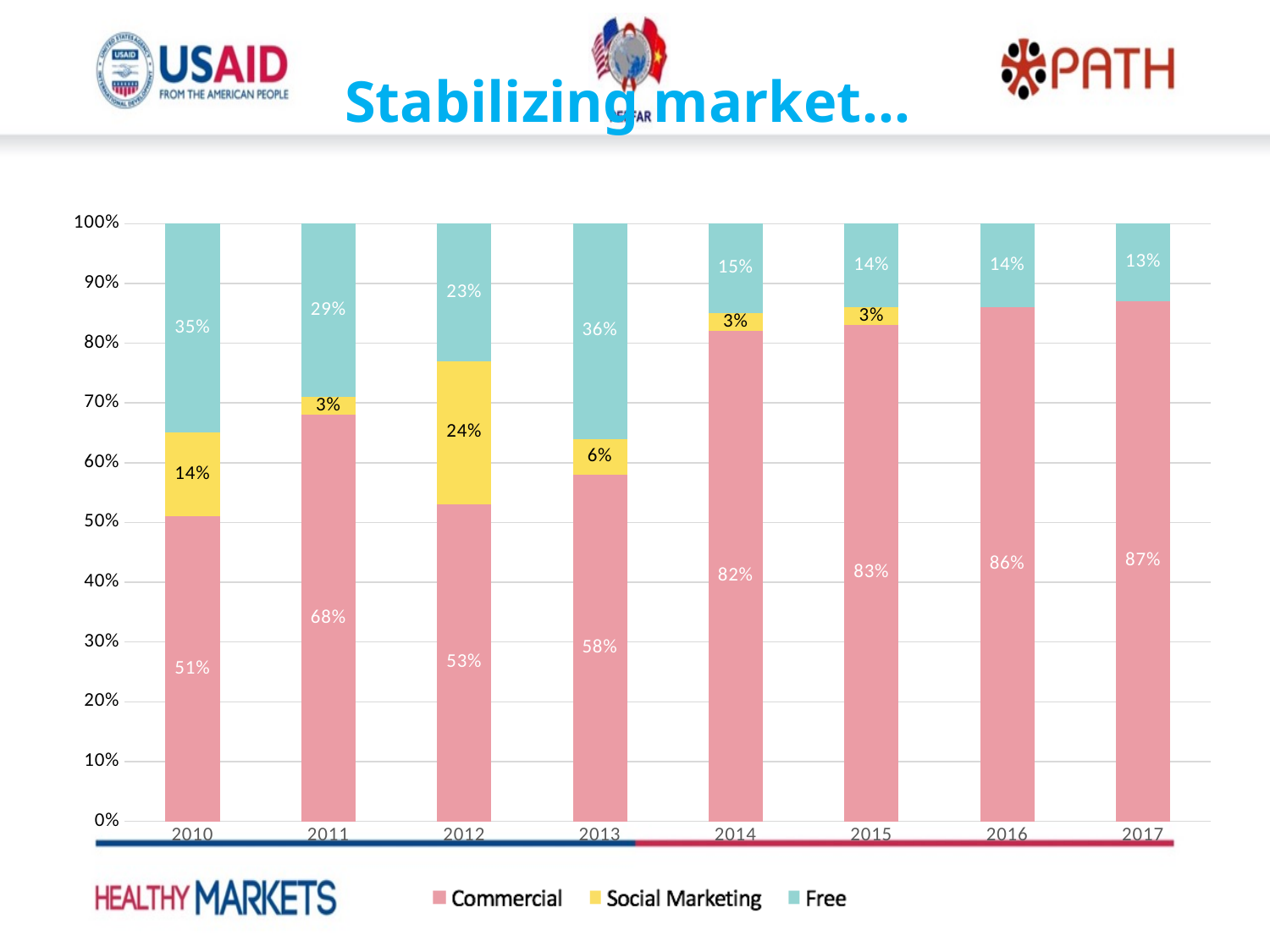
Which is larger, the Free share in 2011 or the Free share in 2012? 2011 In which year is the Free share lowest? 2017 Does the Commercial share generally rise or fall from 2013 to 2017? Rise What is the Social Marketing share in 2012? 24% What is the Commercial share in 2010? 51% What is the Commercial share in 2017? 87% What kind of chart is shown on the slide? Stacked bar chart In which year is the Commercial share highest? 2017 How many years are shown on the x axis? 8 What is the Free share in 2013? 36% How many series does the legend list? 3 What is the difference between the Commercial share in 2017 and in 2010? 36%